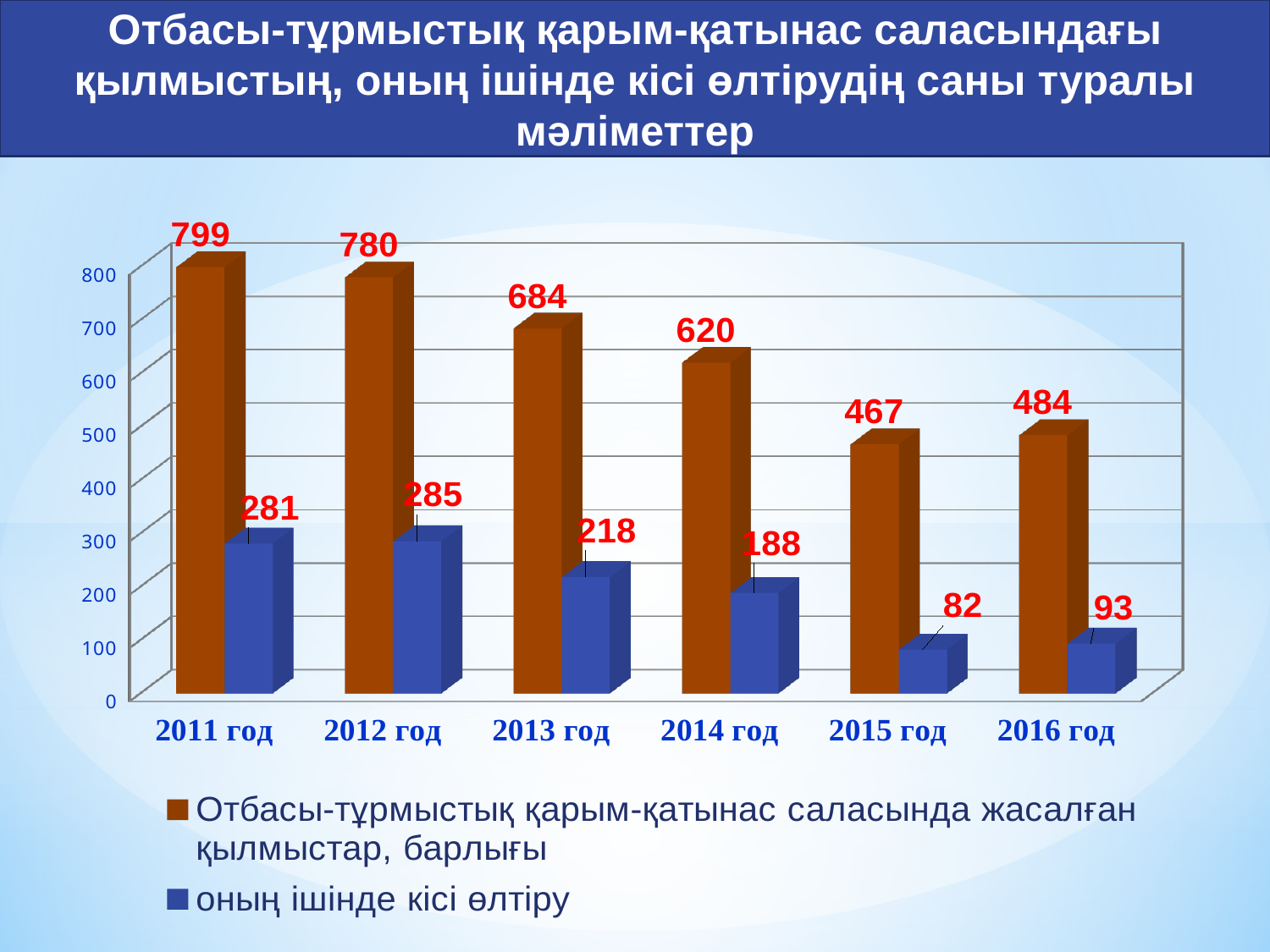
What is the value of the murders series (оның ішінде кісі өлтіру) for 2014 год? 188 What is the difference between the total crimes value for 2011 год and for 2012 год? 19 What is the value of the murders series (оның ішінде кісі өлтіру) for 2016 год? 93 How many series does the legend list? 2 In which year is the murders series (оның ішінде кісі өлтіру) at its highest? 2012 год What kind of chart is shown on the slide? Bar chart What is the value of the total family-domestic crimes series (Отбасы-тұрмыстық қарым-қатынас саласында жасалған қылмыстар, барлығы) for 2011 год? 799 How many years (categories) are shown on the x axis? 6 What is the difference between the murders value for 2013 год and for 2014 год? 30 Which is larger: the total crimes value for 2015 год or for 2016 год? 2016 год Which colour represents the murders series (оның ішінде кісі өлтіру) in the legend? Blue In which year is the total family-domestic crimes series at its lowest? 2015 год